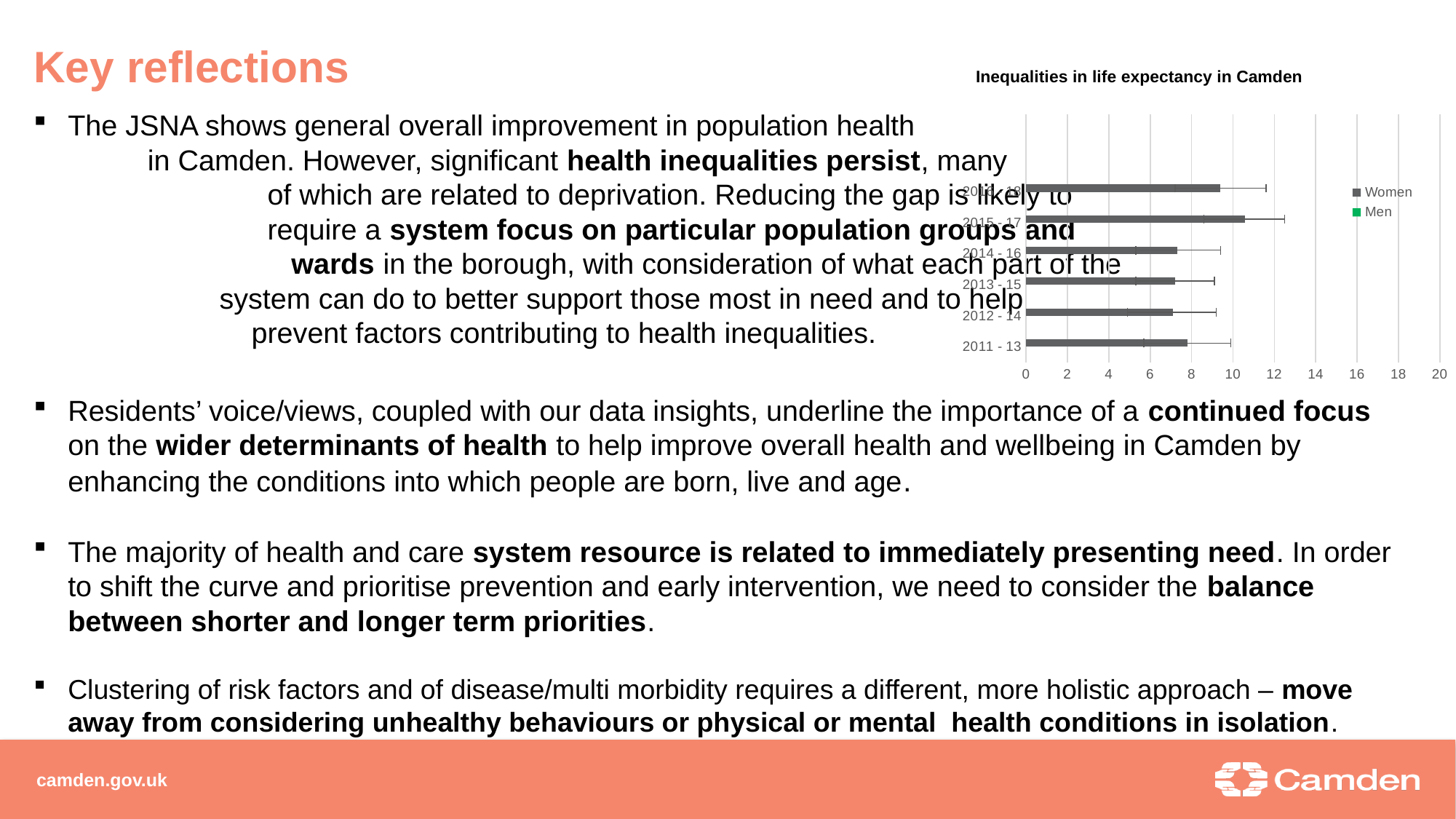
Is the Women value for 2014 - 16 greater or less than 8? less Is the Women value for 2011 - 13 greater or less than 6? greater How many series does the chart legend list? 2 Which is larger, the Women value for 2015 - 17 or for 2014 - 16? 2015 - 17 Is the Women value for 2012 - 14 greater or less than 8? less How many bars are plotted in the chart? 6 Which is larger, the Women value for 2015 - 17 or for 2011 - 13? 2015 - 17 What colour does the legend use for the Men series? green What kind of chart is shown on the slide? bar chart Which period has the highest Women value in the chart? 2015 - 17 What is the title of the chart on the slide? Inequalities in life expectancy in Camden